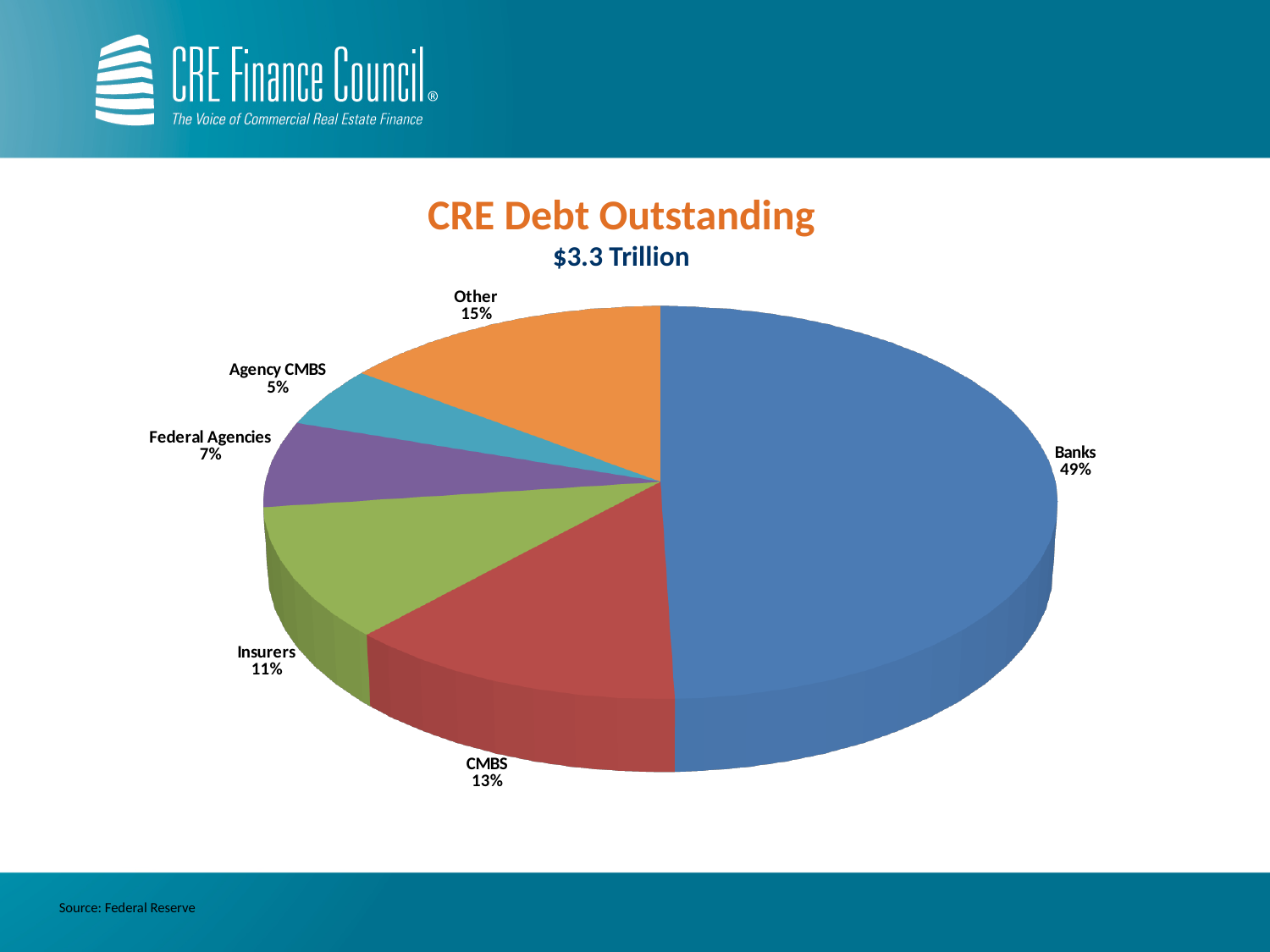
What share of CRE debt outstanding is held by Insurers? 11% What share of CRE debt outstanding is held by Banks? 49% What total amount of CRE debt outstanding is stated in the chart subtitle? $3.3 Trillion What share of CRE debt outstanding is Agency CMBS? 5% Which category holds the largest share of CRE debt outstanding? Banks Which category holds the smallest share of CRE debt outstanding? Agency CMBS What share of CRE debt outstanding is CMBS? 13% What type of chart is shown on the slide? Pie chart What is the source cited for the chart? Federal Reserve What is the difference in percentage points between the Other slice and the Federal Agencies slice? 8 percentage points How many categories are shown in the pie chart? 6 Which is larger, the CMBS share or the Insurers share? CMBS